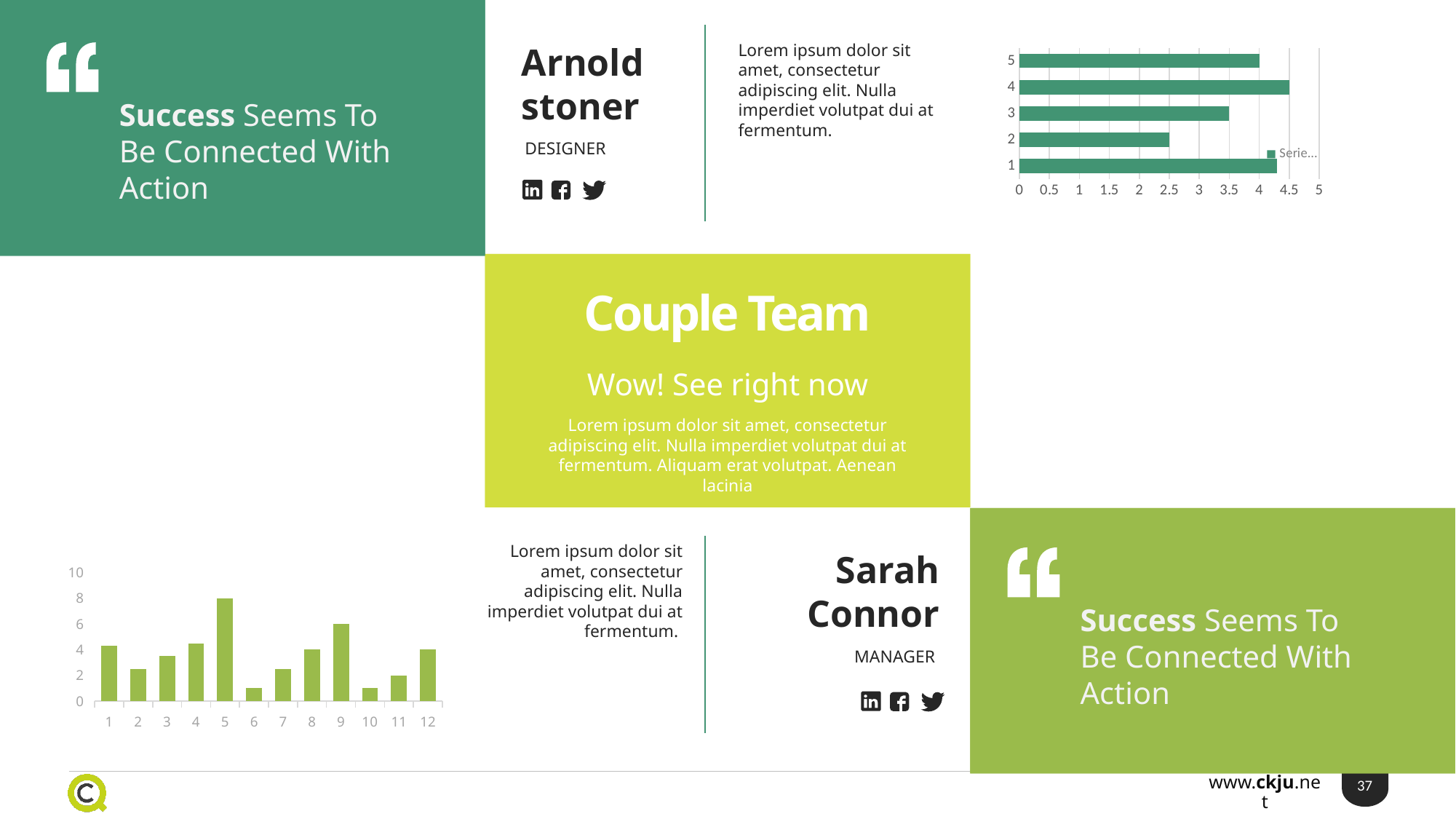
In the top-right bar chart, is the value for category 2 greater or less than 3? less In the bottom-left bar chart, which category has the highest value? 5 In the bottom-left bar chart, which is larger, the value for category 5 or the value for category 9? category 5 What kind of chart is the chart in the bottom-left corner of the slide? bar chart In the bottom-left bar chart, is the value for category 6 greater or less than 2? less In the top-right bar chart, which category has the lowest value? 2 In the bottom-left bar chart, is the value for category 9 greater or less than 4? greater In the top-right bar chart, which is larger, the value for category 3 or the value for category 2? category 3 In the top-right bar chart, how many categories are plotted? 5 What kind of chart is the chart in the top-right corner of the slide? bar chart In the bottom-left bar chart, how many categories are plotted? 12